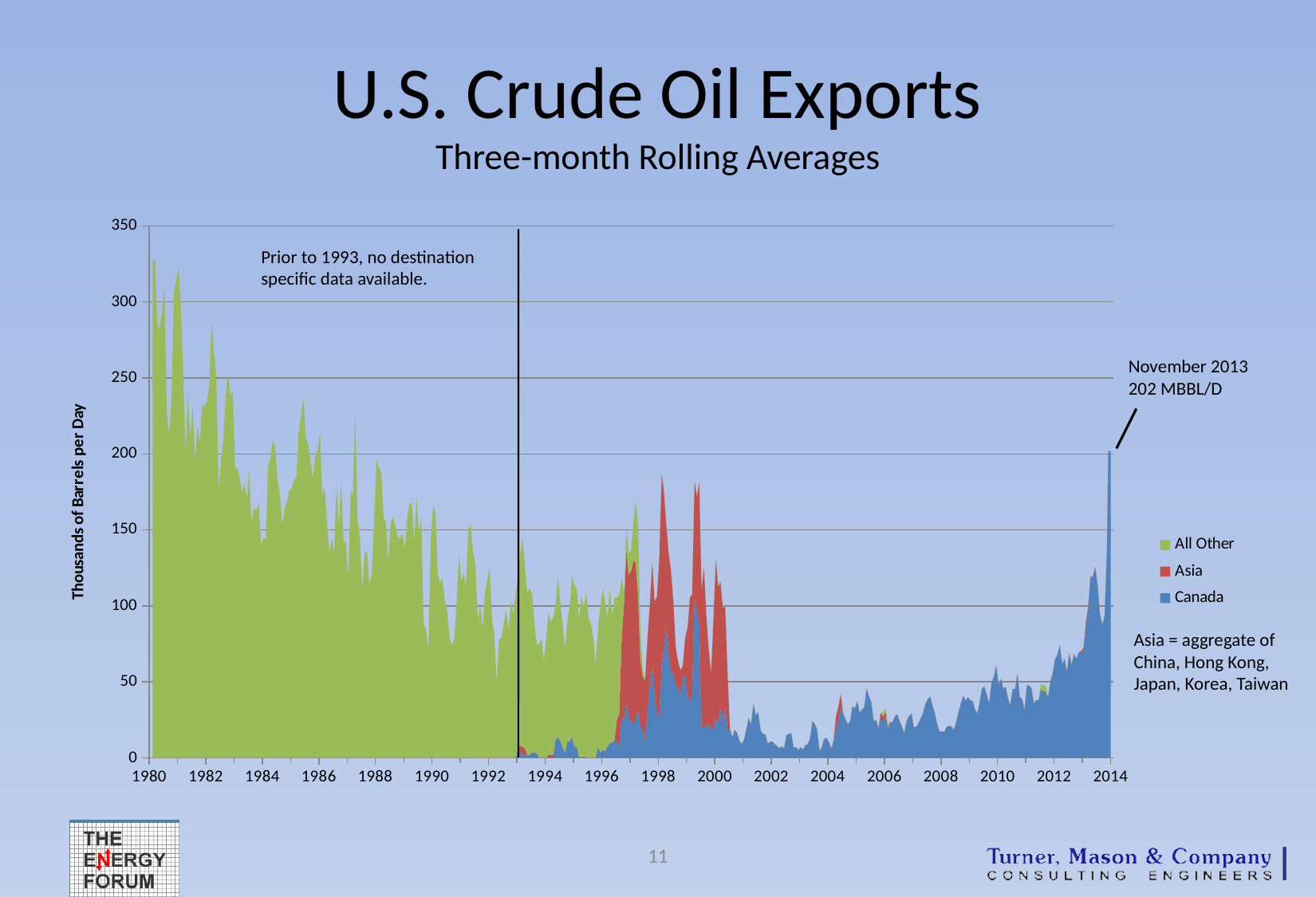
Is the total value in 2003 greater or less than 50? less Is the peak value in 1998 greater or less than 150? greater What are the three series listed in the legend? All Other, Asia, Canada Do the values generally rise or fall from 1980 to 1992? fall What is the title of the chart on the slide? U.S. Crude Oil Exports Do the values generally rise or fall from 2010 to 2014? rise What kind of chart is shown on the slide? Area chart Which series accounts for nearly all exports from 2002 to 2014? Canada How many series does the legend list? 3 What value is annotated for November 2013? 202 MBBL/D Is the value at the start of 1980 greater or less than 300? greater Which is larger in 1980: the value for All Other or the value for Canada? All Other